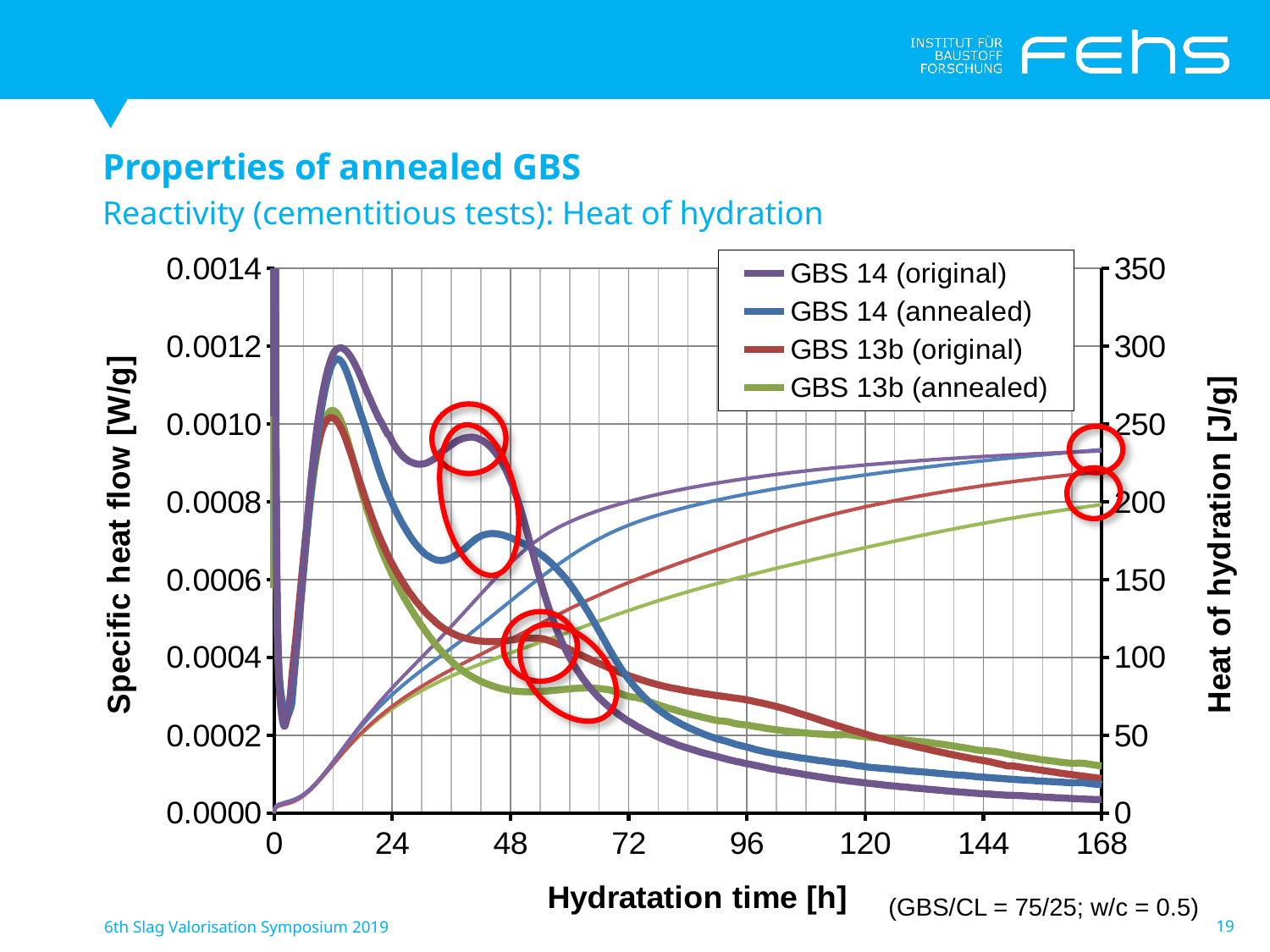
Which series has the lowest heat of hydration at 168 h? GBS 13b (annealed) Is the heat of hydration of GBS 13b (annealed) at 168 h greater or less than 250? less Is the heat of hydration of GBS 14 (original) at 168 h greater or less than 200? greater What is the label of the right-hand y axis? Heat of hydration [J/g] What kind of chart is shown on the slide? line chart What is the label of the x axis? Hydratation time [h] Do the heat of hydration curves rise or fall as hydration time increases? rise What is the highest value shown on the x axis? 168 How many series does the legend list? 4 At 168 h, which has the higher heat of hydration, GBS 14 (original) or GBS 13b (annealed)? GBS 14 (original) How many tick labels are shown on the x axis? 8 Which has the higher peak specific heat flow, GBS 14 (original) or GBS 13b (original)? GBS 14 (original)